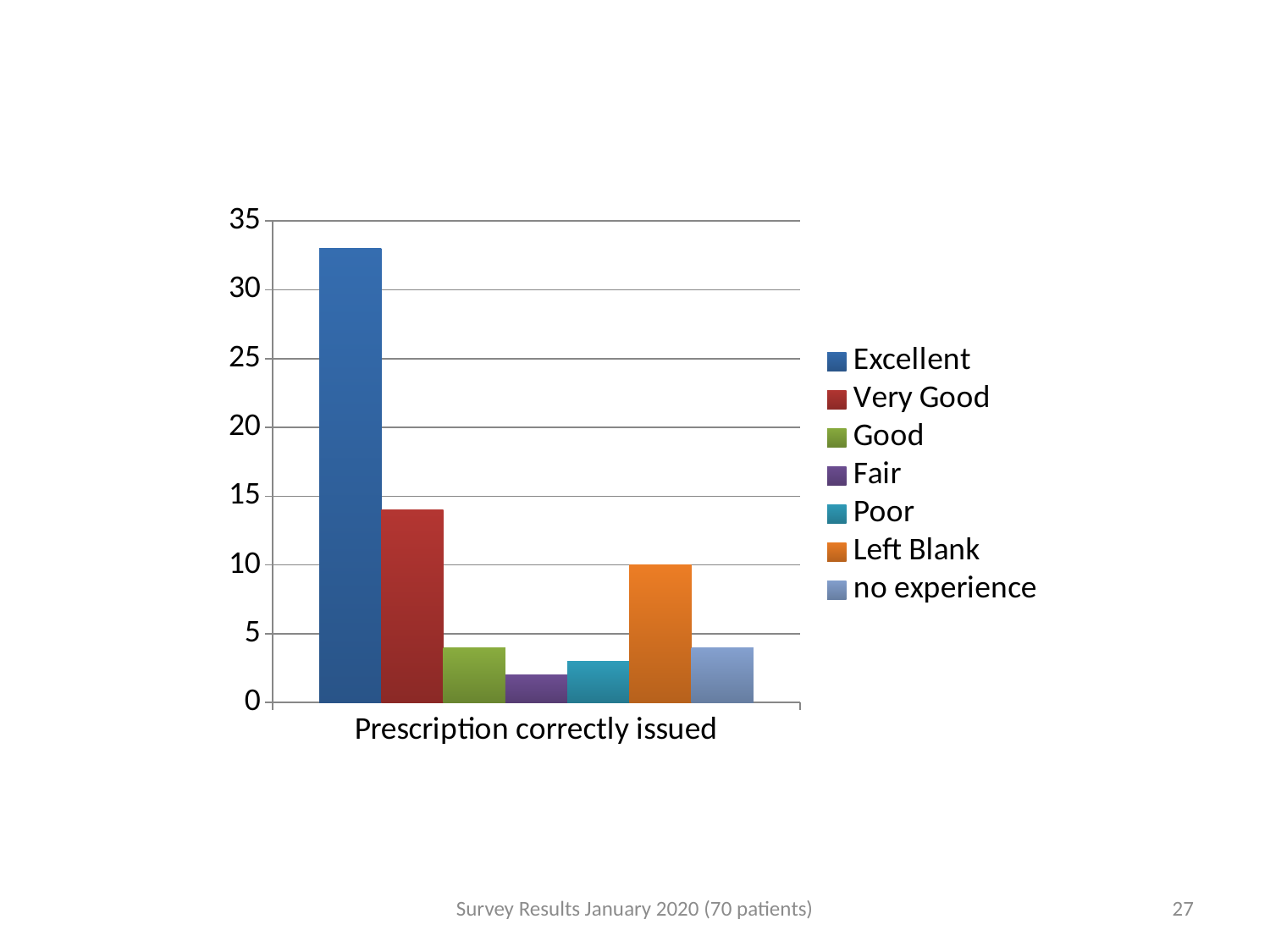
Is the value for Very Good greater or less than 15? less Which is larger, the value for Excellent or the value for Very Good? Excellent Is the value for Poor greater or less than 5? less What is the category label shown on the x axis? Prescription correctly issued What colour is the bar for Left Blank? orange What kind of chart is shown on the slide? bar chart How many series does the legend list? 7 Which series has the highest value? Excellent Is the value for Excellent greater or less than 30? greater Which is larger, the value for Left Blank or the value for Good? Left Blank What is the value for Left Blank? 10